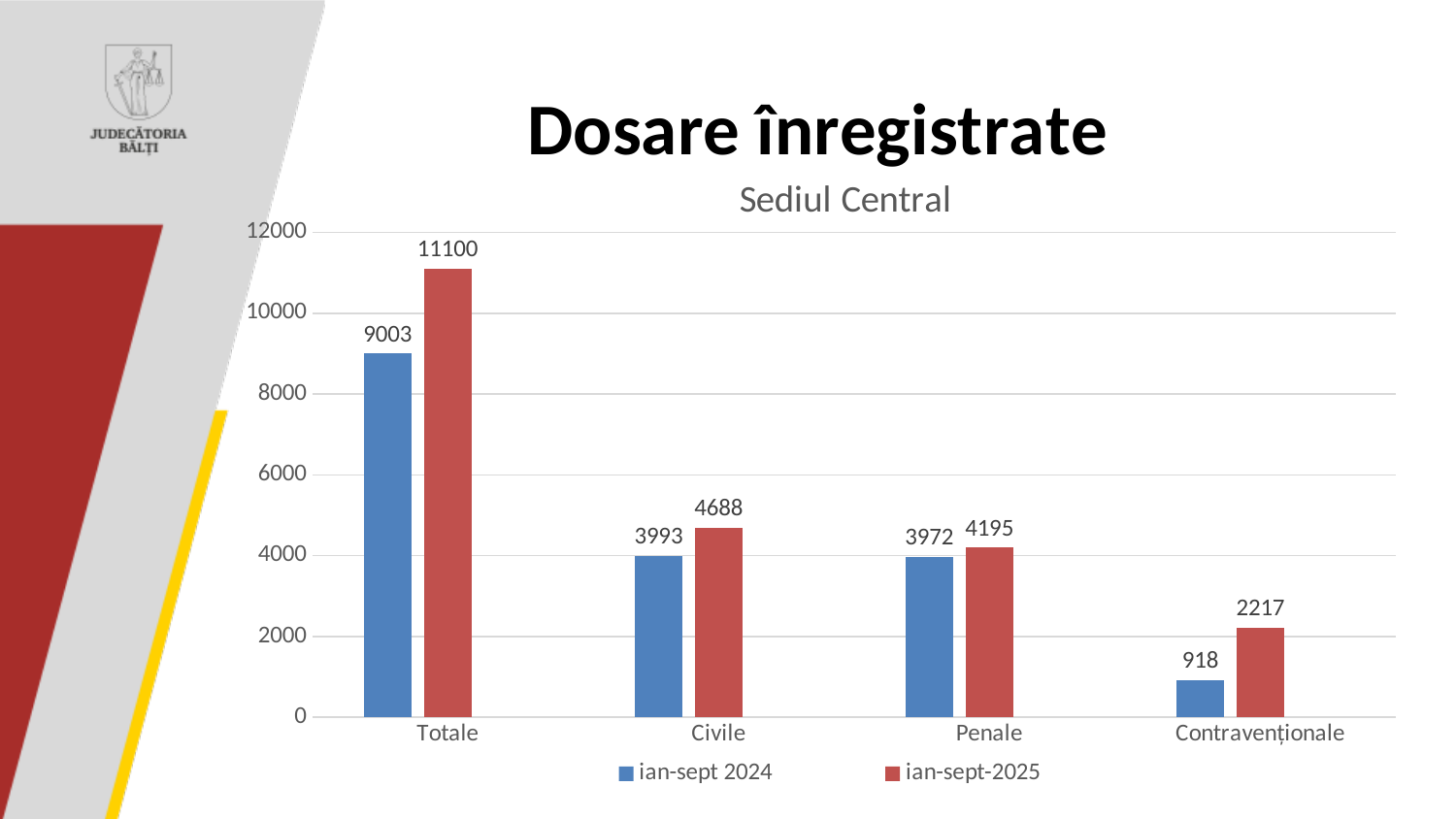
How many categories are shown on the x axis? 4 What is the value for Totale in the ian-sept 2024 series? 9003 What kind of chart is shown on the slide? Bar chart Which category has the lowest value in the ian-sept 2024 series? Contravenționale What is the value for Penale in the ian-sept-2025 series? 4195 What is the value for Contravenționale in the ian-sept 2024 series? 918 What is the value for Civile in the ian-sept-2025 series? 4688 What is the difference between the ian-sept-2025 and ian-sept 2024 values for Totale? 2097 What is the difference between the ian-sept-2025 and ian-sept 2024 values for Contravenționale? 1299 Which is larger for Civile: the ian-sept 2024 value or the ian-sept-2025 value? ian-sept-2025 Which category has the highest value in the ian-sept-2025 series? Totale How many series does the legend list? 2